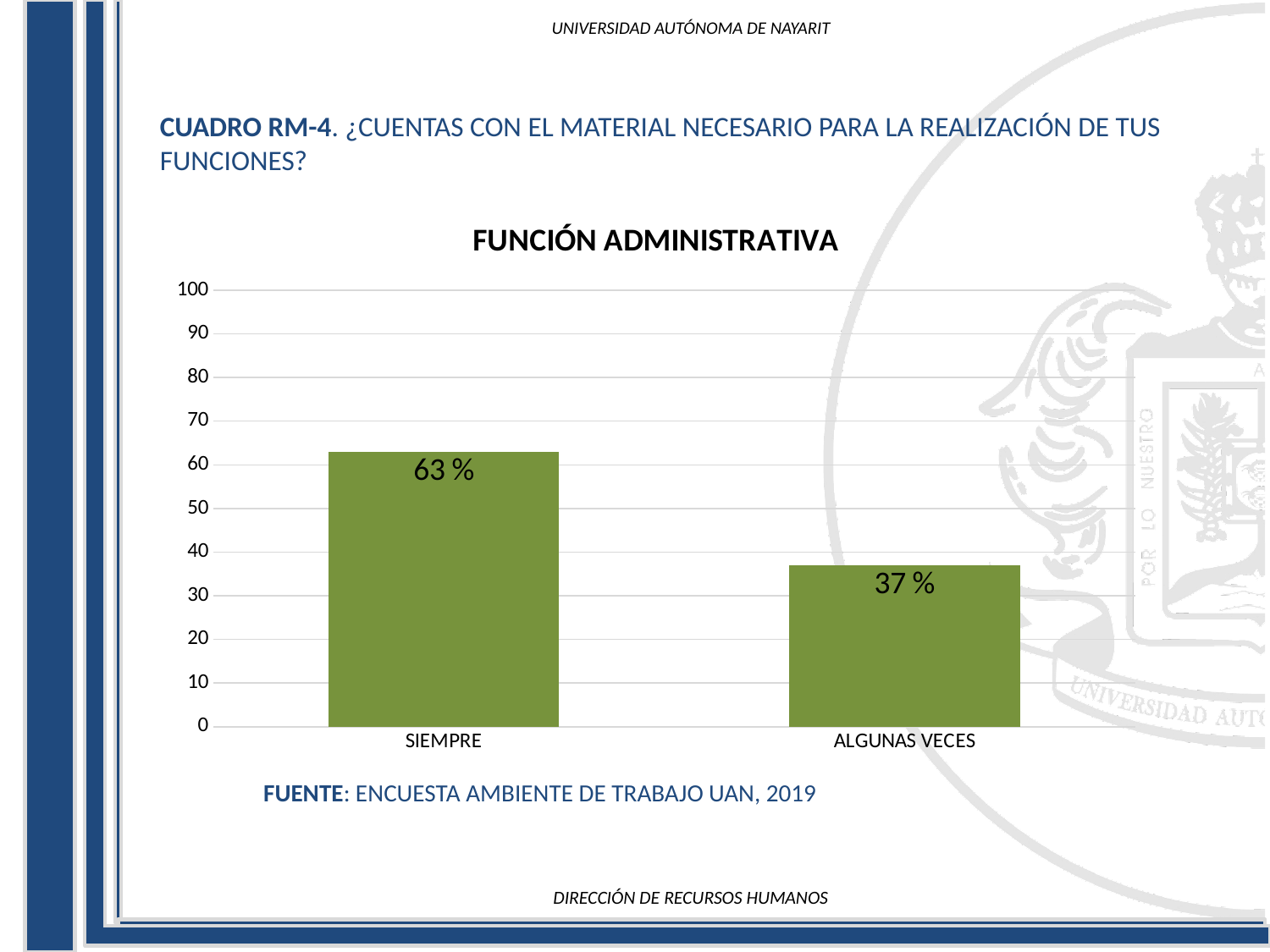
Is the value for SIEMPRE greater or less than 60? greater What is the difference between the values for SIEMPRE and ALGUNAS VECES? 26 % What kind of chart is shown? bar chart What is the value for ALGUNAS VECES? 37 % What is the title of the chart? FUNCIÓN ADMINISTRATIVA How many categories are shown on the x axis? 2 Is the value for ALGUNAS VECES greater or less than 50? less Which category has the lowest value? ALGUNAS VECES What is the maximum value shown on the y axis? 100 What is the value for SIEMPRE? 63 % Which category has the highest value? SIEMPRE Which is larger, the value for SIEMPRE or the value for ALGUNAS VECES? SIEMPRE